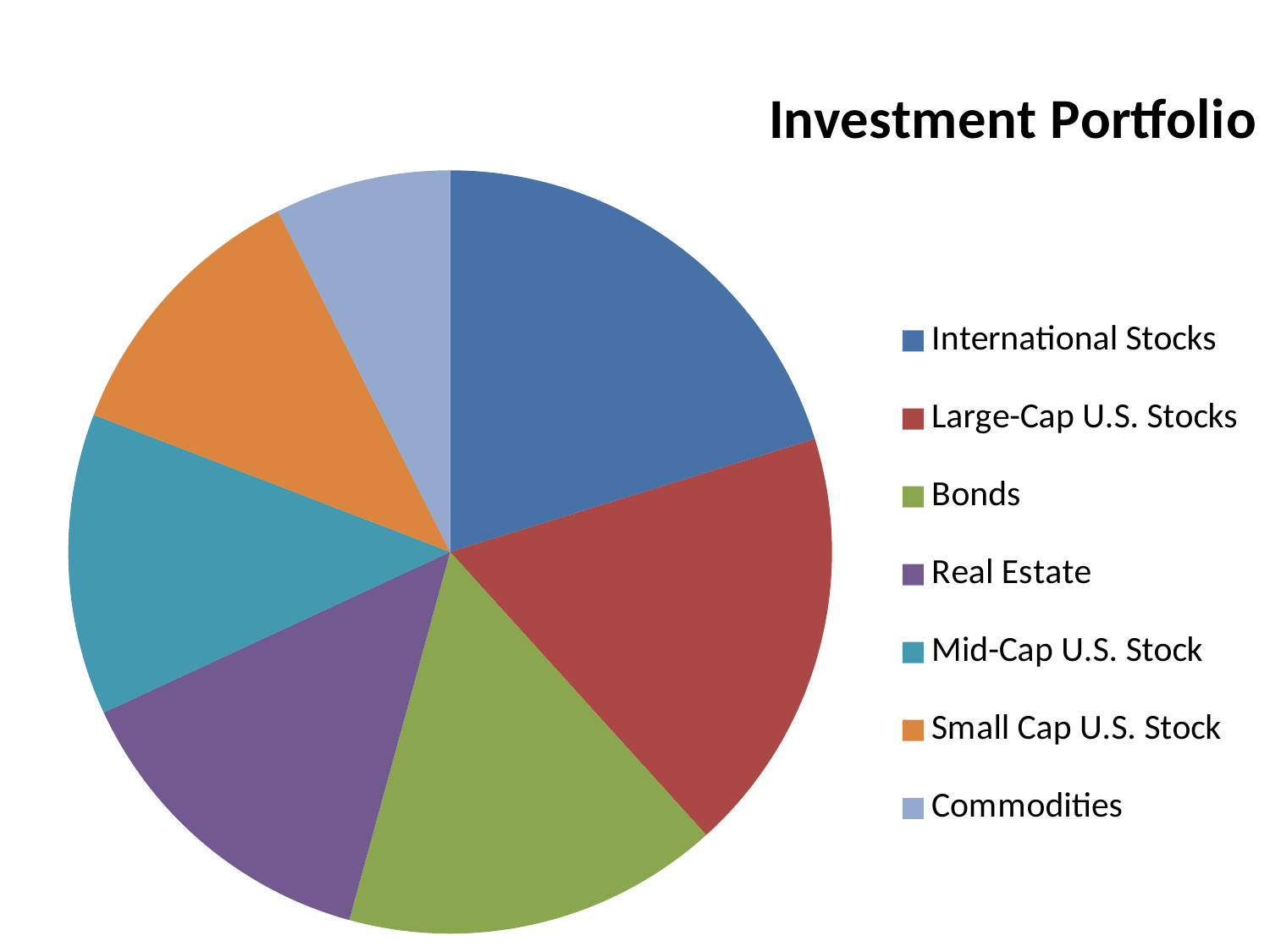
How many slices does the pie chart have? 7 Which category has the smallest slice of the pie? Commodities Which slice is larger, International Stocks or Commodities? International Stocks Which category is shown in green in the pie chart? Bonds Which slice is larger, International Stocks or Mid-Cap U.S. Stock? International Stocks Which slice is larger, Bonds or Commodities? Bonds What kind of chart is shown on the slide? Pie chart What is the title of the chart? Investment Portfolio How many entries does the legend list? 7